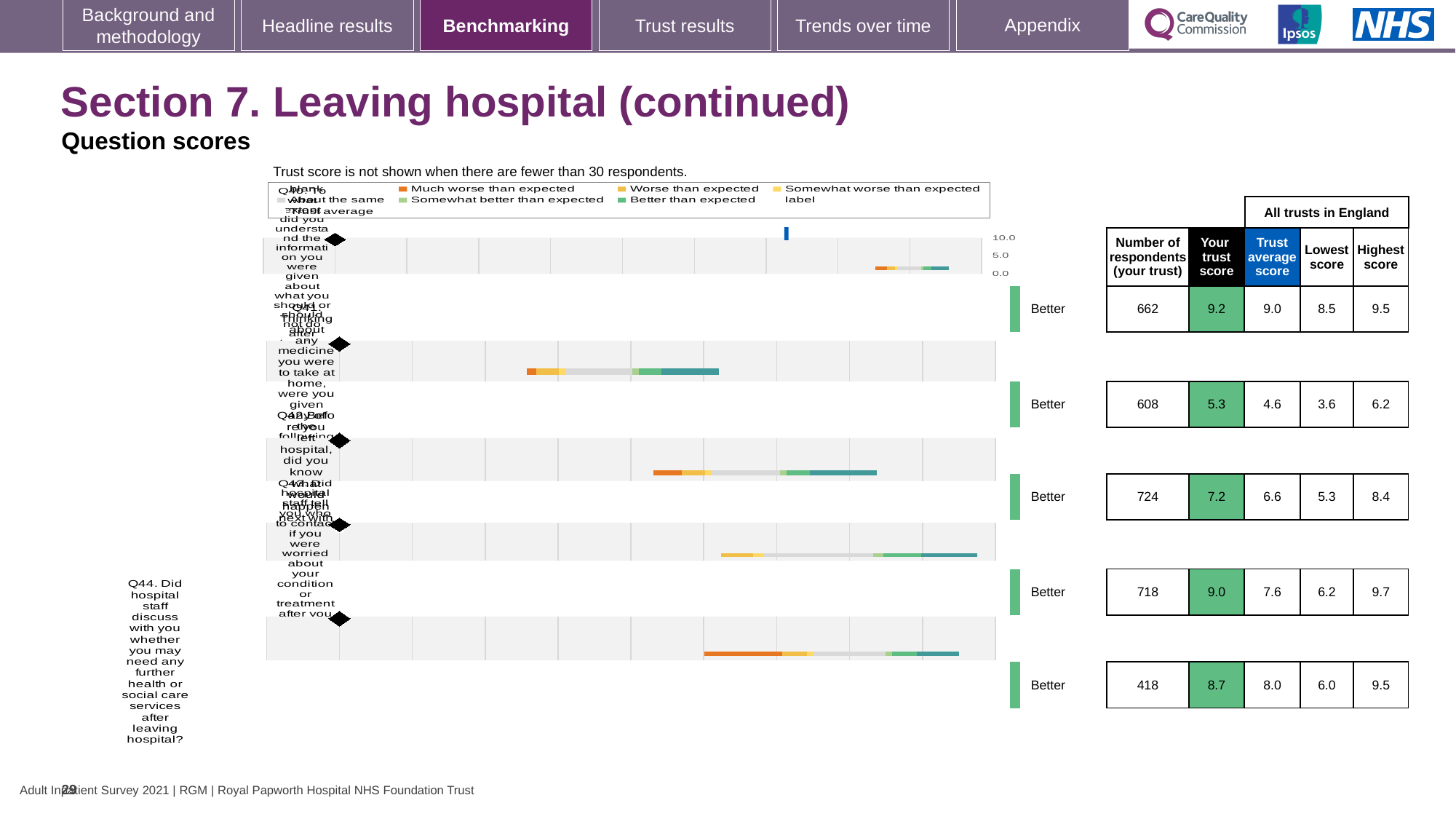
How many questions are plotted on the chart? 5 What is the trust score for the top (first) question on the slide? 9.2 What is the largest number of respondents shown for any question on the slide? 724 What comparison label is shown next to each question on the chart? Better By how much does the trust score for Q44 exceed the trust average score? 0.7 What is the trust score for Q44 (Did hospital staff discuss with you whether you may need any further health or social care services after leaving hospital?)? 8.7 For Q44, which is larger: the trust score or the trust average score? Trust score What is the trust average score for Q44? 8.0 What is the highest score across all trusts in England for Q44? 9.5 What is the lowest 'Your trust score' shown on the slide? 5.3 How many respondents answered Q44 at this trust? 418 What is the lowest score across all trusts in England for Q44? 6.0